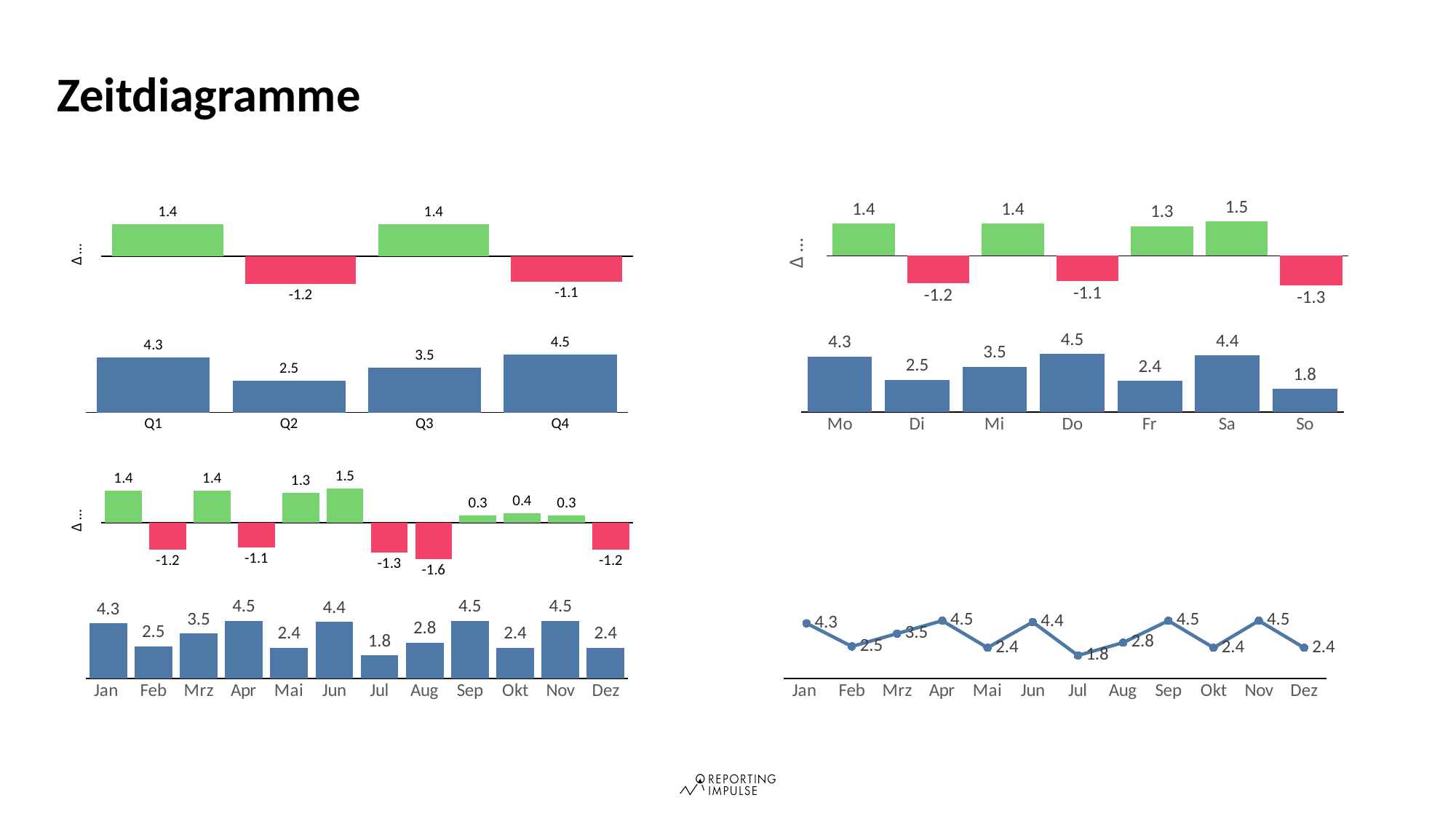
In the delta chart above the monthly bars at the bottom left, what is the value for Aug? -1.6 In the line chart at the bottom right, what is the value for Jul? 1.8 In the delta chart above the weekday bars at the top right, what is the value for Sa? 1.5 In the monthly bar chart at the bottom left, what is the value for Aug? 2.8 In the quarterly bar chart at the top left, which quarter has the highest value? Q4 In the weekday bar chart at the top right, which day has the lowest value? So In the quarterly bar chart at the top left, what is the value for Q3? 3.5 In the weekday bar chart at the top right, how many categories are shown on the x axis? 7 What kind of chart is shown at the bottom right of the slide? Line chart In the quarterly bar chart at the top left, what is the difference between Q4 and Q2? 2.0 In the monthly bar chart at the bottom left, which is larger, Mrz or Mai? Mrz In the weekday bar chart at the top right, what is the value for Fr? 2.4